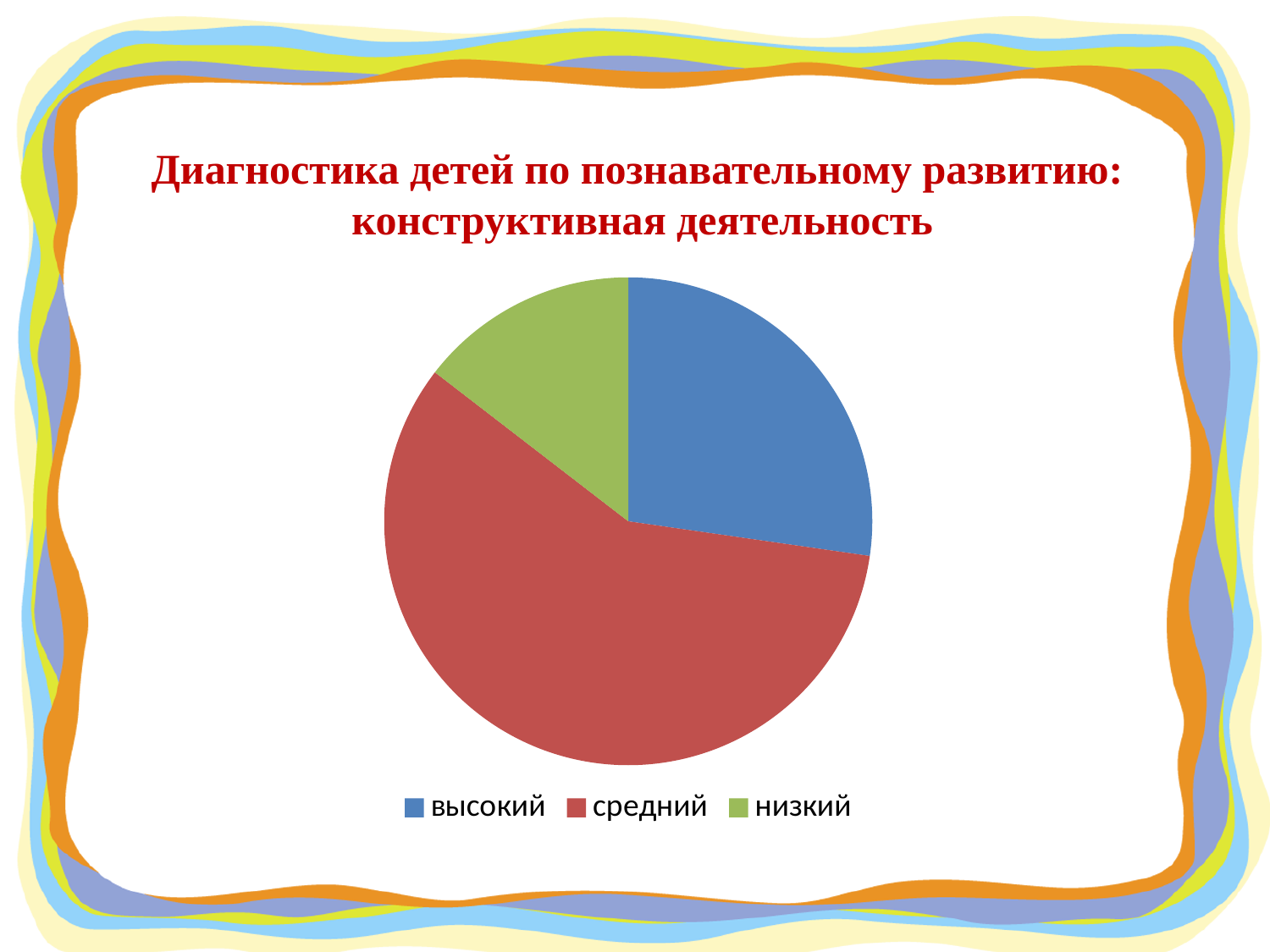
How many entries does the legend of the pie chart list? 3 What colour is the slice for низкий in the pie chart? green Which category has the largest slice of the pie chart? средний What kind of chart is shown on the slide? pie chart Which category has the smallest slice of the pie chart? низкий What is the title of the chart on the slide? Диагностика детей по познавательному развитию: конструктивная деятельность Which slice is larger, средний or низкий? средний Which slice is larger, средний or высокий? средний Which slice is larger, высокий or низкий? высокий How many slices does the pie chart have? 3